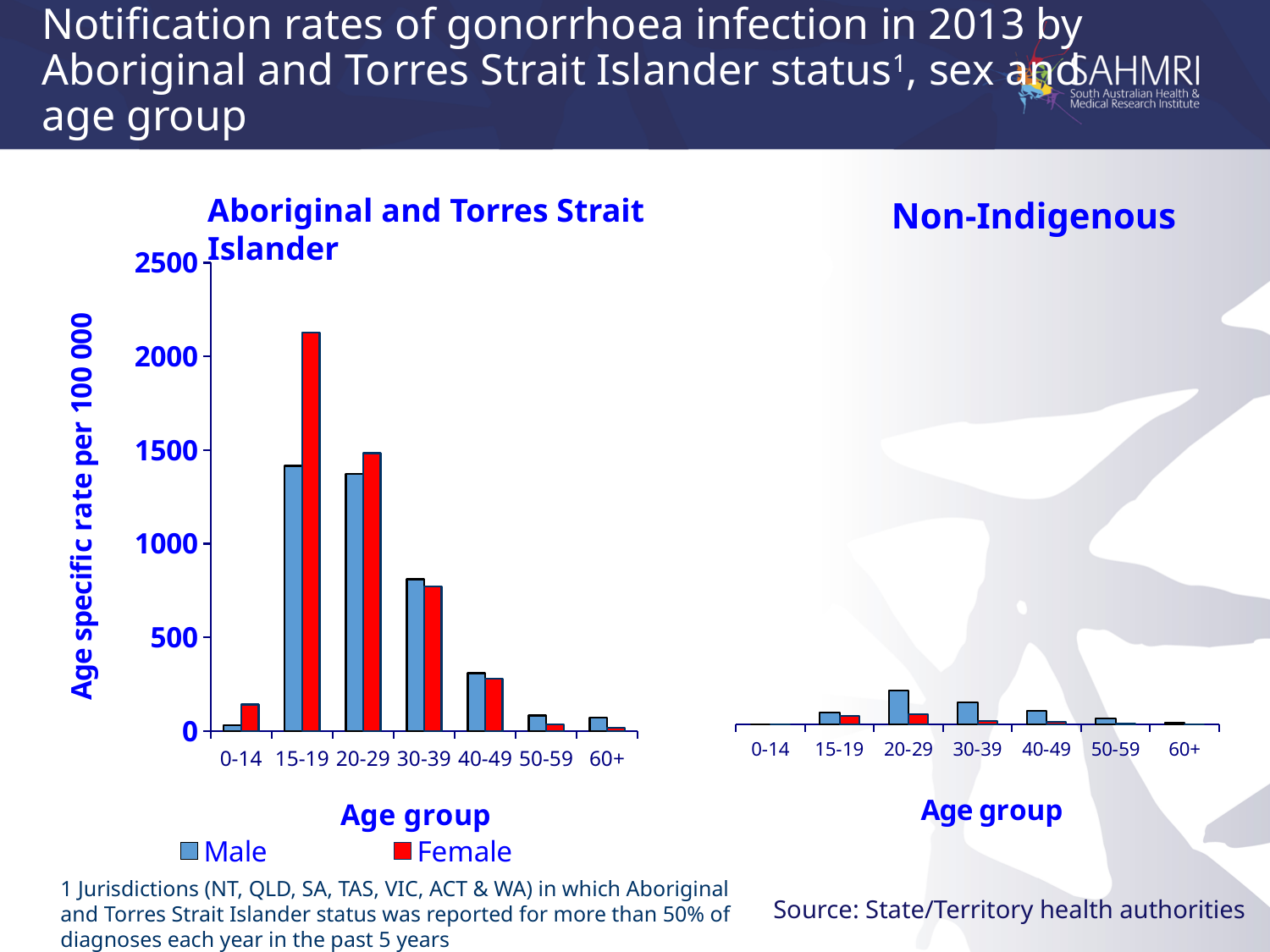
In the Aboriginal and Torres Strait Islander chart, which is larger for the 15-19 age group, Male or Female? Female In the Aboriginal and Torres Strait Islander chart, which age group has the highest Female rate? 15-19 In the Aboriginal and Torres Strait Islander chart, do the Male values rise or fall from 20-29 to 60+? Fall In the Aboriginal and Torres Strait Islander chart, is the Female value for 40-49 greater or less than 500? less How many series does the legend list? 2 In the Aboriginal and Torres Strait Islander chart, which is larger for the 50-59 age group, Male or Female? Male In the Aboriginal and Torres Strait Islander chart, is the Male value for 30-39 greater or less than 500? greater How many age groups are shown on the x axis of the Non-Indigenous chart? 7 What kind of chart is the Aboriginal and Torres Strait Islander chart? Bar chart In the Aboriginal and Torres Strait Islander chart, is the Male value for 15-19 greater or less than 1500? less In the Non-Indigenous chart, which age group has the highest Male rate? 20-29